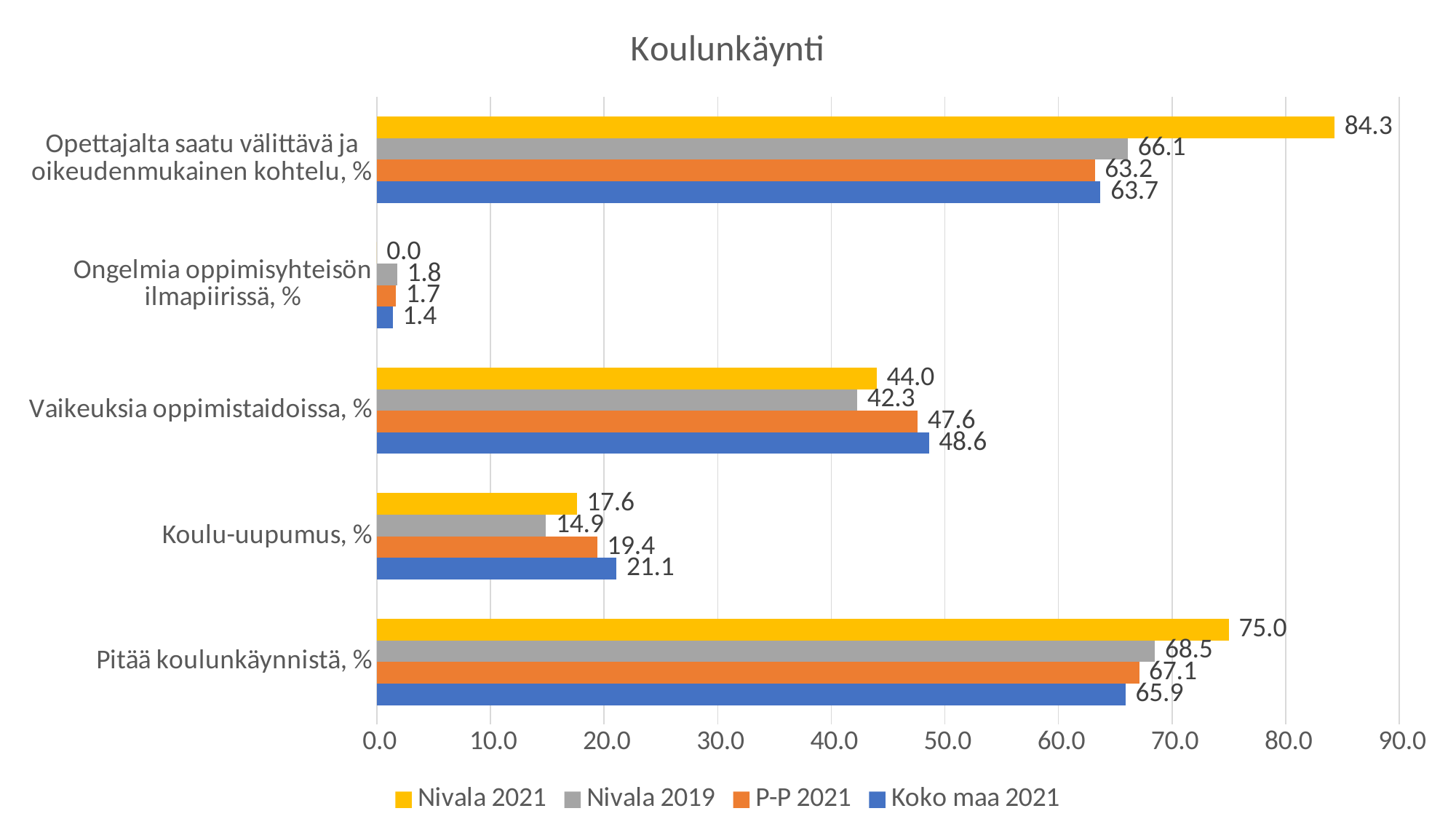
In the category "Vaikeuksia oppimistaidoissa, %", which is larger: the value for P-P 2021 or the value for Koko maa 2021? Koko maa 2021 Which series has the lowest value in the category "Ongelmia oppimisyhteisön ilmapiirissä, %"? Nivala 2021 What is the value for Nivala 2019 in the category "Vaikeuksia oppimistaidoissa, %"? 42.3 What is the value for P-P 2021 in the category "Pitää koulunkäynnistä, %"? 67.1 Which series has the highest value in the category "Pitää koulunkäynnistä, %"? Nivala 2021 How many categories are shown on the y axis of the chart? 5 How many series does the legend list? 4 What is the title of the chart? Koulunkäynti What is the value for Nivala 2021 in the category "Opettajalta saatu välittävä ja oikeudenmukainen kohtelu, %"? 84.3 What is the value for Koko maa 2021 in the category "Koulu-uupumus, %"? 21.1 What is the difference between the Nivala 2021 and Nivala 2019 values in the category "Opettajalta saatu välittävä ja oikeudenmukainen kohtelu, %"? 18.2 What kind of chart is shown on the slide? Bar chart